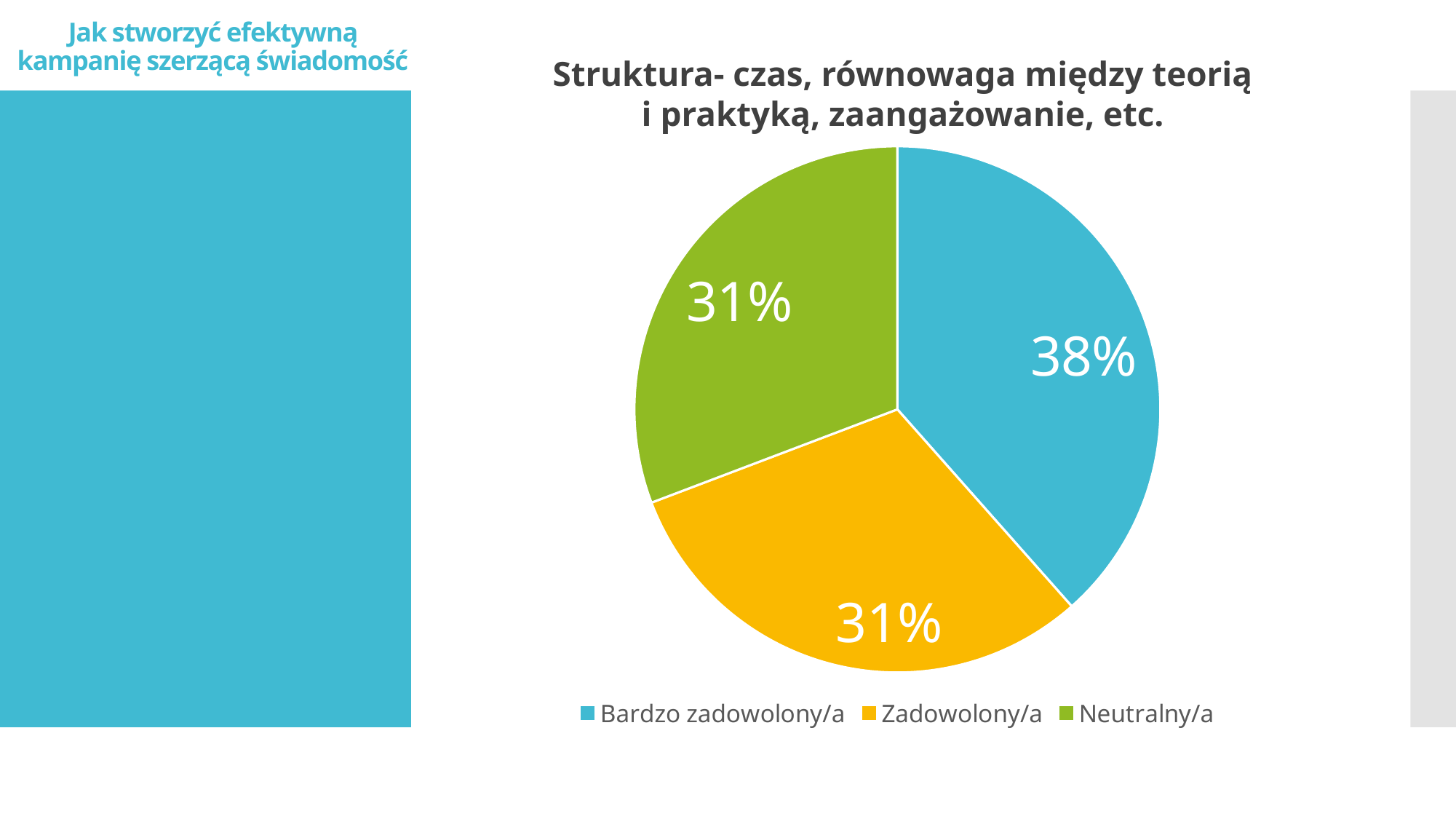
Which is larger, the share for "Bardzo zadowolony/a" or the share for "Zadowolony/a"? Bardzo zadowolony/a What kind of chart is shown on the slide? Pie chart What share of the pie does "Neutralny/a" have? 31% What is the title of the chart? Struktura- czas, równowaga między teorią i praktyką, zaangażowanie, etc. Is the share for "Bardzo zadowolony/a" greater or less than 50%? less Which colour represents "Neutralny/a" in the pie chart? Green How many categories does the pie chart show? 3 Which category has the largest slice of the pie? Bardzo zadowolony/a What share of the pie does "Zadowolony/a" have? 31% What share of the pie does "Bardzo zadowolony/a" have? 38% What is the difference between the shares of "Bardzo zadowolony/a" and "Neutralny/a"? 7%